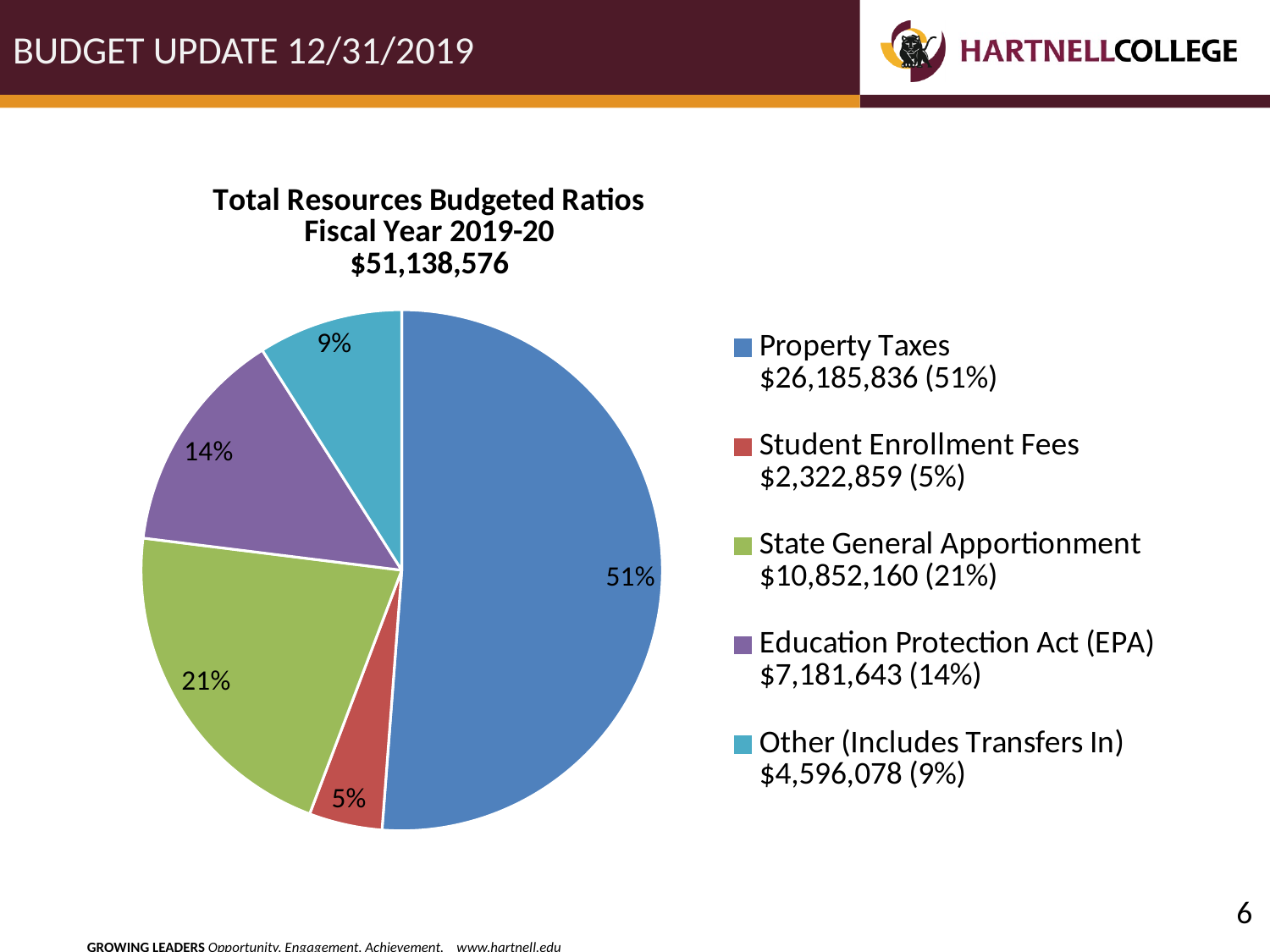
What total dollar amount is shown in the chart title? $51,138,576 What kind of chart is shown on the slide? pie chart What is the dollar amount shown for Education Protection Act (EPA)? $7,181,643 How many categories does the pie chart have? 5 Which category has the largest slice of the pie? Property Taxes What is the difference in percentage points between State General Apportionment and Education Protection Act (EPA)? 7 percentage points What share of the pie does State General Apportionment represent? 21% What share of the pie does Other (Includes Transfers In) represent? 9% Which is larger, the share for Education Protection Act (EPA) or the share for Other (Includes Transfers In)? Education Protection Act (EPA) What share of the pie does Property Taxes represent? 51% Which category has the smallest slice of the pie? Student Enrollment Fees What is the dollar amount shown for Student Enrollment Fees? $2,322,859